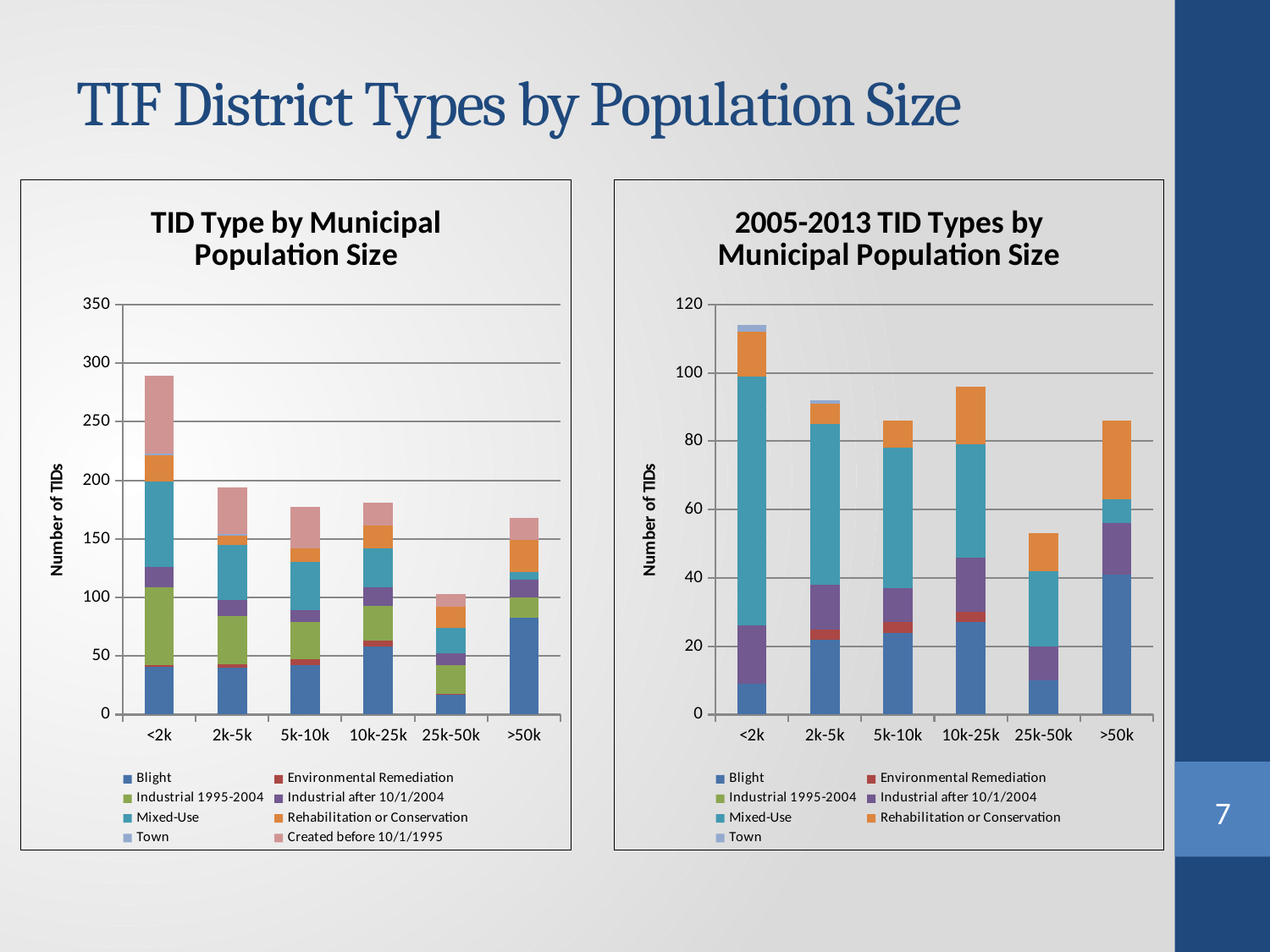
In the left chart, 'TID Type by Municipal Population Size', is the total number of TIDs for 25k-50k greater or less than 150? less In the left chart, 'TID Type by Municipal Population Size', which population size category has the tallest stacked bar? <2k In the right chart, '2005-2013 TID Types by Municipal Population Size', is the total number of TIDs for 25k-50k greater or less than 60? less In the left chart, 'TID Type by Municipal Population Size', is the total number of TIDs for <2k greater or less than 250? greater In the left chart, 'TID Type by Municipal Population Size', which has a taller stacked bar: 2k-5k or 5k-10k? 2k-5k How many population size categories are shown on the x axis of the right chart, '2005-2013 TID Types by Municipal Population Size'? 6 In the right chart, '2005-2013 TID Types by Municipal Population Size', which population size category has the shortest stacked bar? 25k-50k In the right chart, '2005-2013 TID Types by Municipal Population Size', which population size category has the tallest stacked bar? <2k What type of chart is the right chart, '2005-2013 TID Types by Municipal Population Size'? Stacked bar chart In the left chart, 'TID Type by Municipal Population Size', which population size category has the shortest stacked bar? 25k-50k How many series does the legend of the left chart, 'TID Type by Municipal Population Size', list? 8